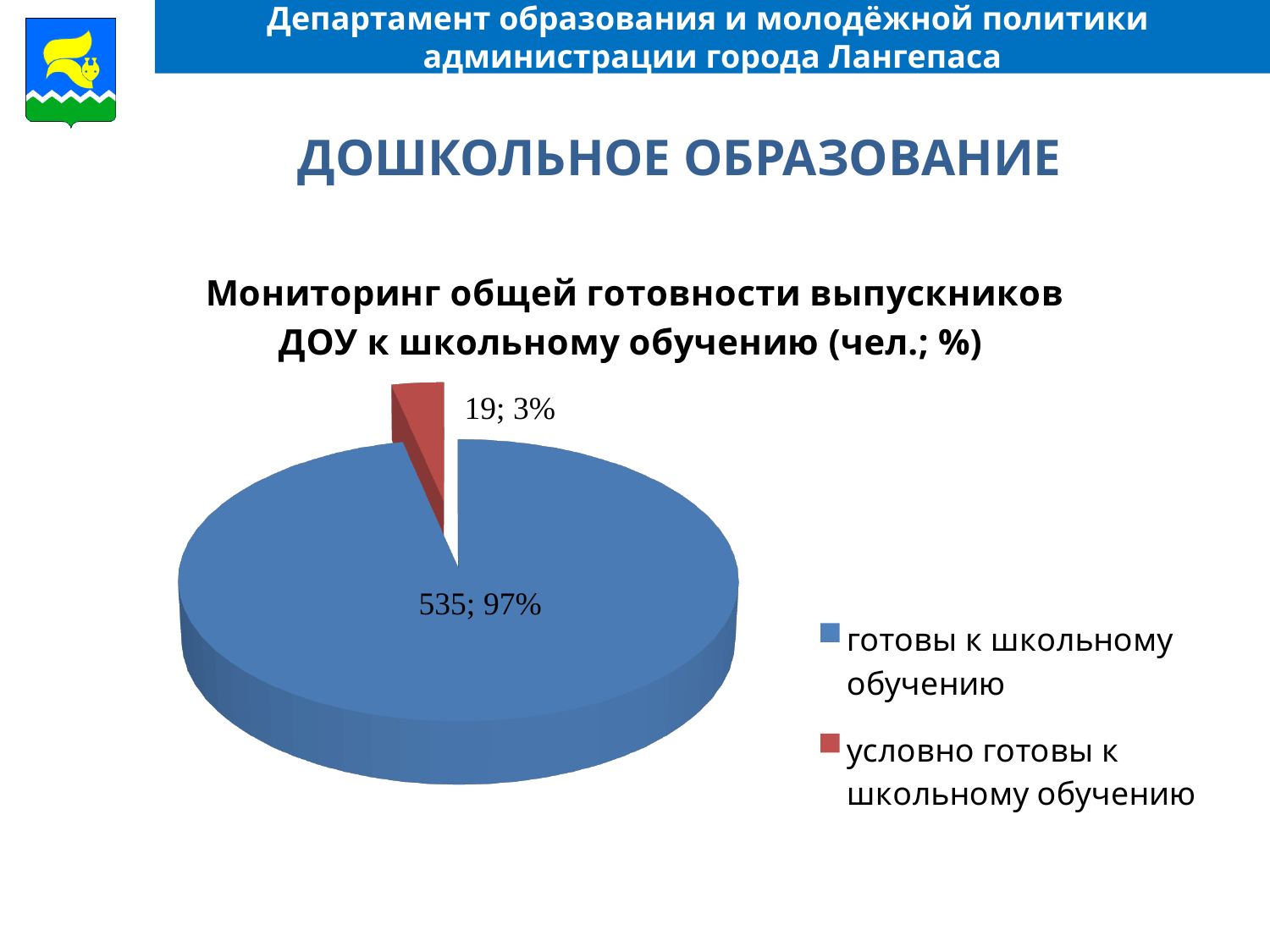
How many people are in the 'готовы к школьному обучению' category? 535 What colour is the slice for 'условно готовы к школьному обучению'? red How many people are in the 'условно готовы к школьному обучению' category? 19 How many entries does the legend list? 2 What share of the pie does 'условно готовы к школьному обучению' represent? 3% How many slices does the pie chart have? 2 What is the total number of people represented in the pie chart? 554 What is the difference in number of people between 'готовы к школьному обучению' and 'условно готовы к школьному обучению'? 516 Which category has the smallest slice? условно готовы к школьному обучению Which category has the largest slice? готовы к школьному обучению What kind of chart is shown on the slide? pie chart What share of the pie does 'готовы к школьному обучению' represent? 97%